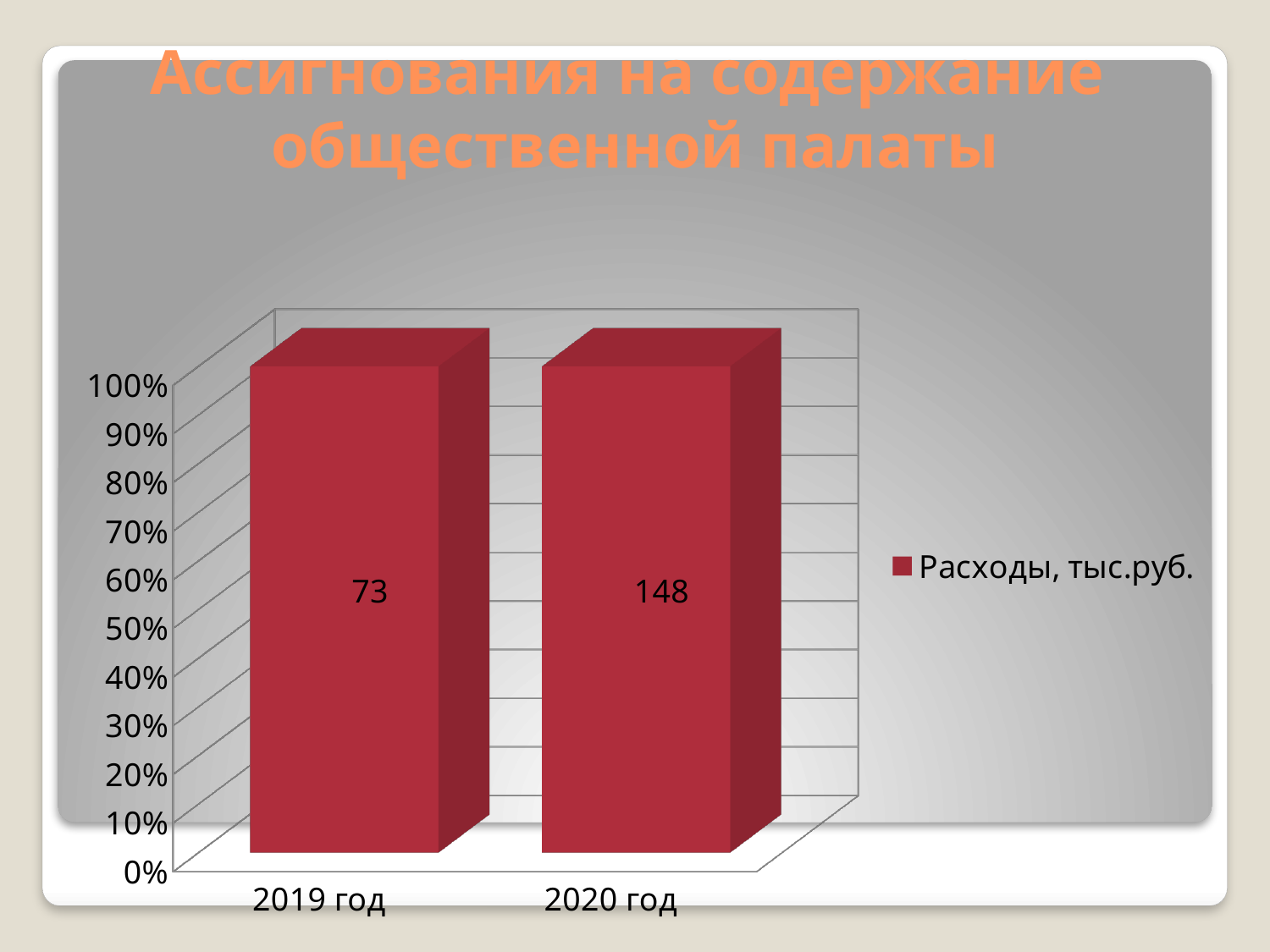
Which category has the lowest labelled value? 2019 год Do the labelled values rise or fall from 2019 год to 2020 год? Rise What series name is shown in the legend? Расходы, тыс.руб. What is the difference between the labelled values for 2020 год and 2019 год? 75 What is the value shown for 2019 год? 73 What is the value shown for 2020 год? 148 How many categories are shown on the x axis? 2 What is the title of the chart? Ассигнования на содержание общественной палаты Which category has the highest labelled value? 2020 год How many series does the legend list? 1 Which year has the higher labelled value, 2019 год or 2020 год? 2020 год What kind of chart is shown on the slide? Bar chart